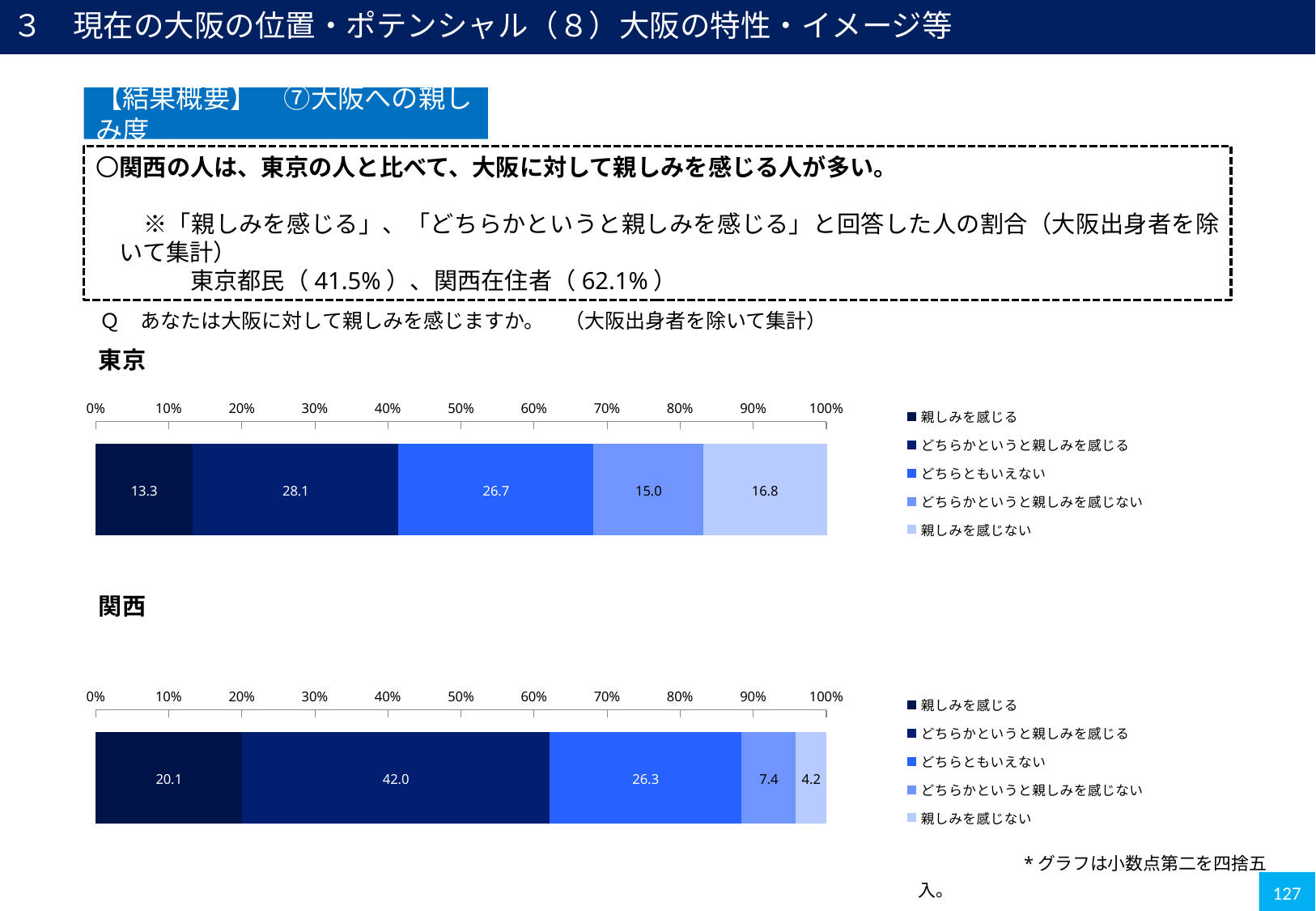
In the 東京 chart, what is the value for 親しみを感じる? 13.3 In the 東京 chart, which is larger: どちらともいえない or 親しみを感じない? どちらともいえない In the 東京 chart, what is the value for どちらかというと親しみを感じる? 28.1 In the 関西 chart, what is the total of the 親しみを感じる and どちらかというと親しみを感じる segments? 62.1 In the 関西 chart, what is the value for 親しみを感じない? 4.2 In the 東京 chart, which segment has the smallest value? 親しみを感じる What is the label of the first legend entry in the 東京 chart? 親しみを感じる What is the difference between the どちらかというと親しみを感じる value in the 関西 chart and the same segment in the 東京 chart? 13.9 In the 関西 chart, what is the value for どちらかというと親しみを感じる? 42.0 What kind of chart is the 東京 chart? Stacked bar chart How many series does the legend of the 関西 chart list? 5 In the 関西 chart, which segment has the largest value? どちらかというと親しみを感じる